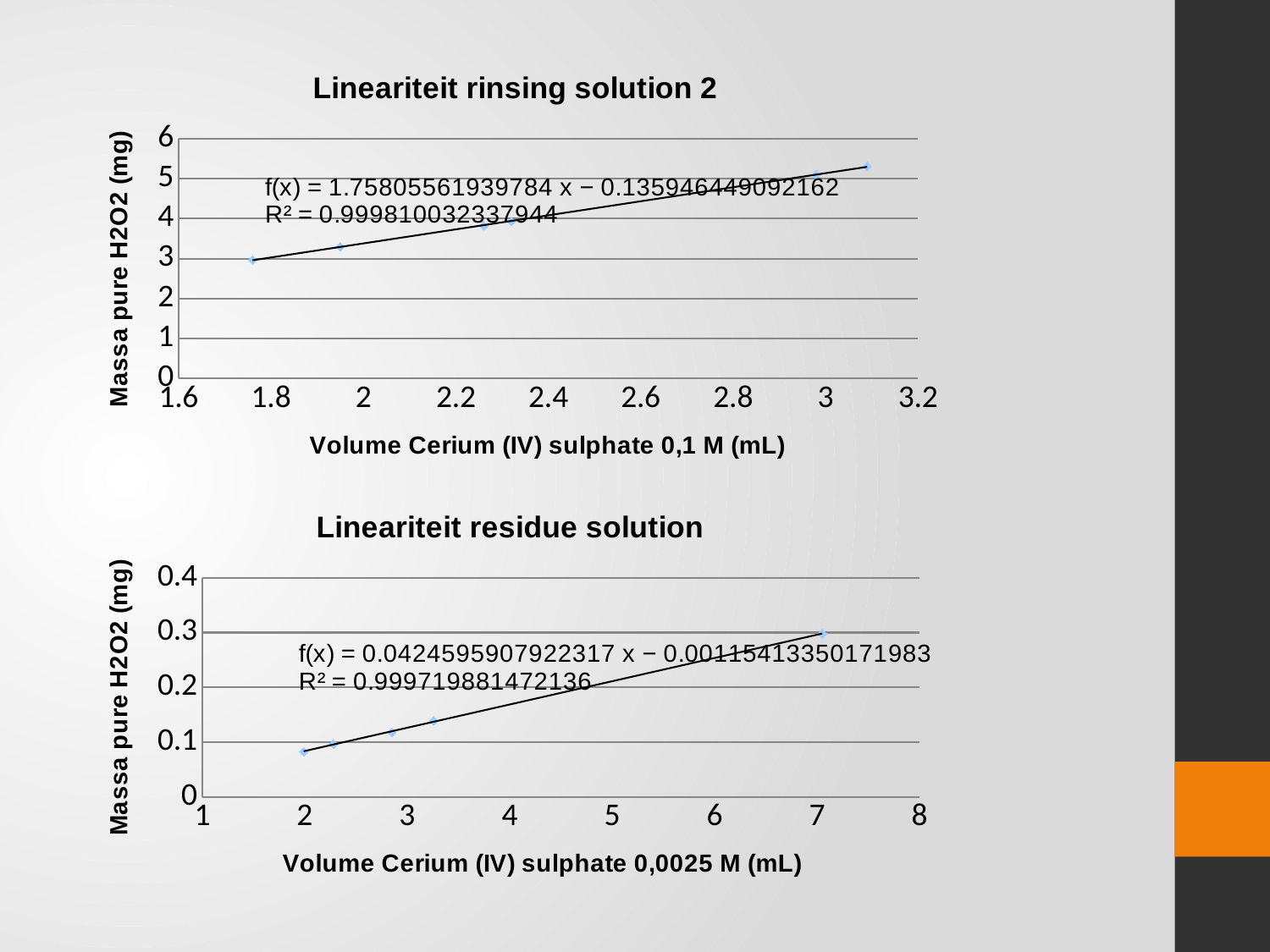
In the bottom chart "Lineariteit residue solution", is the mass of pure H2O2 at the lowest volume (around 2 mL) greater or less than 0.1? less In the bottom chart "Lineariteit residue solution", what is the R² value shown? 0.999719881472136 In the bottom chart "Lineariteit residue solution", what is the slope of the fitted line f(x)? 0.0424595907922317 In the bottom chart "Lineariteit residue solution", do the values rise or fall along the x axis? rise In the top chart "Lineariteit rinsing solution 2", what is the R² value shown? 0.999810032337944 What is the x-axis label of the bottom chart "Lineariteit residue solution"? Volume Cerium (IV) sulphate 0,0025 M (mL) In the top chart "Lineariteit rinsing solution 2", is the mass of pure H2O2 at the highest volume (around 3.1 mL) greater or less than 5? greater In the bottom chart "Lineariteit residue solution", is the mass of pure H2O2 at the highest volume (around 7 mL) greater or less than 0.2? greater What type of chart is the top chart titled "Lineariteit rinsing solution 2"? scatter chart In the top chart "Lineariteit rinsing solution 2", do the values rise or fall as the volume of Cerium (IV) sulphate increases? rise In the top chart "Lineariteit rinsing solution 2", what is the slope of the fitted line f(x)? 1.75805561939784